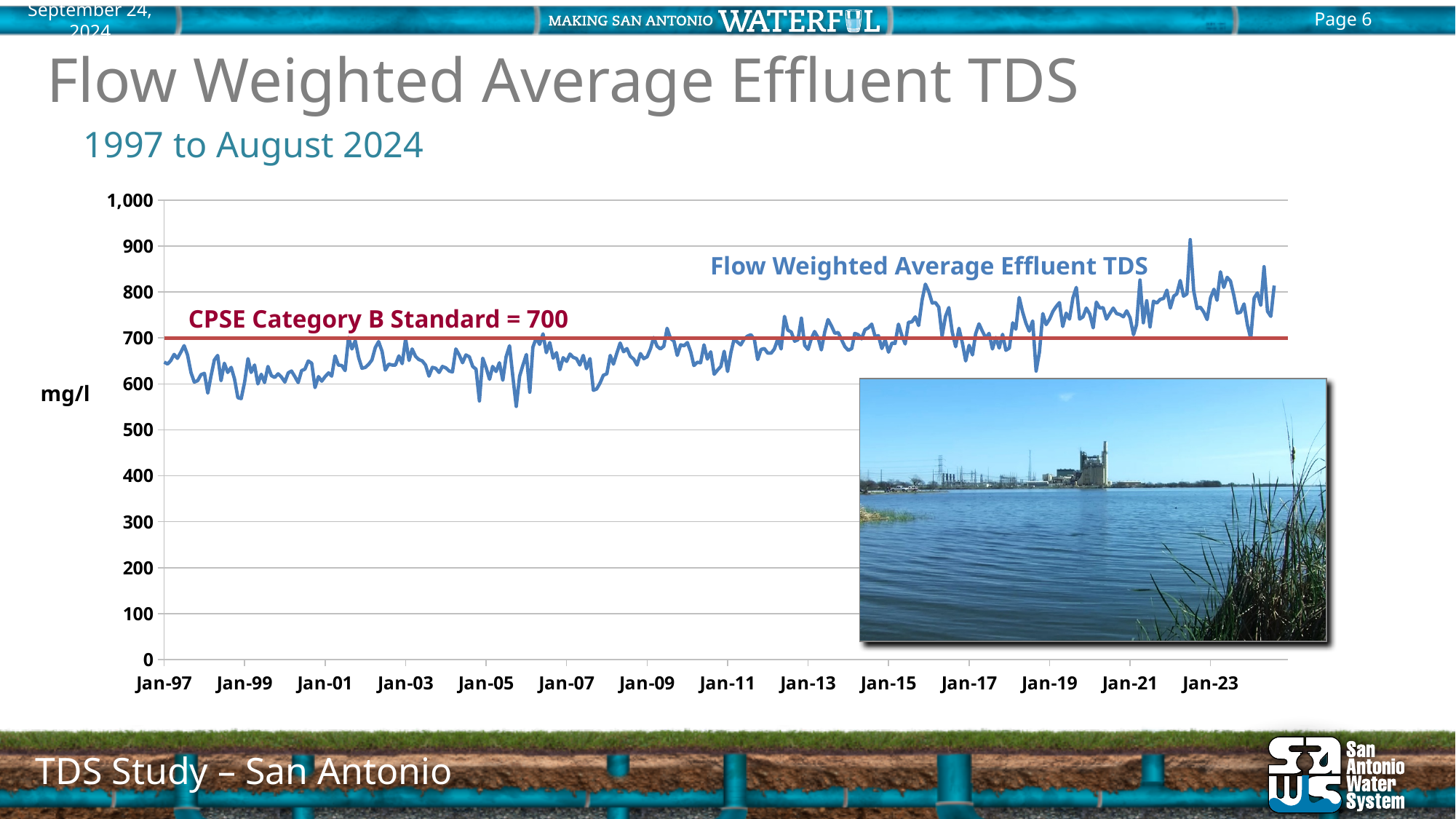
What is the first year label on the x axis? Jan-97 Is the peak Flow Weighted Average Effluent TDS value, reached around 2022, greater or less than 800? greater How many year labels are shown along the x axis? 14 What value is the CPSE Category B Standard line drawn at? 700 Is the Flow Weighted Average Effluent TDS value at Jan-23 greater or less than 700? greater Is the Flow Weighted Average Effluent TDS value at Jan-99 greater or less than 700? less Which is larger: the Flow Weighted Average Effluent TDS at Jan-21 or at Jan-03? Jan-21 Does the Flow Weighted Average Effluent TDS generally rise or fall from Jan-97 to the end of the series? rise What is the highest value shown on the y axis? 1,000 What kind of chart is shown on the slide? line chart What unit is shown on the y axis of the chart? mg/l